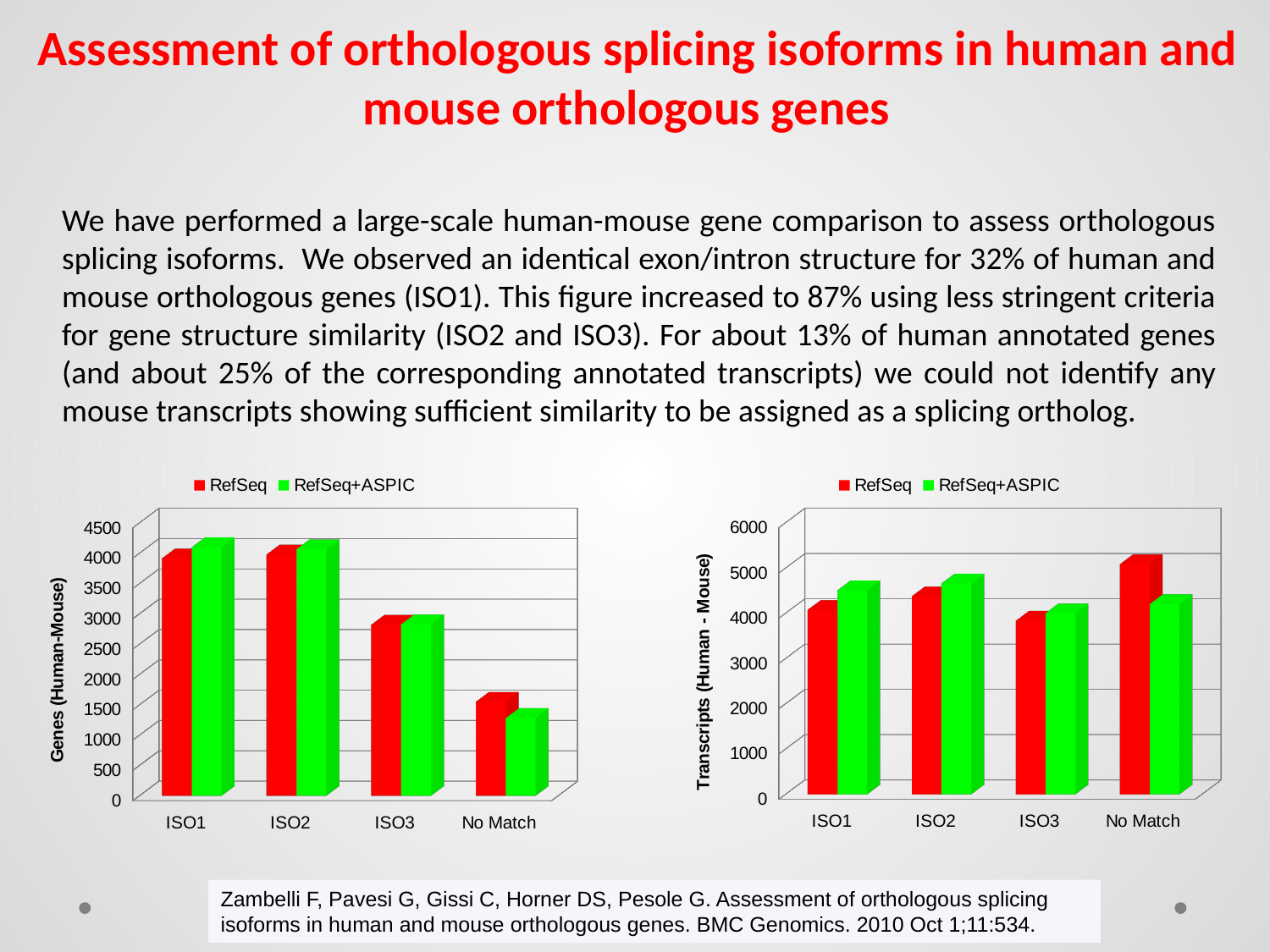
How many series does the legend of the left chart (Genes (Human-Mouse)) list? 2 How many categories are shown on the x axis of the right chart (Transcripts (Human - Mouse))? 4 In the right chart (Transcripts (Human - Mouse)), which category has the lowest RefSeq value? ISO3 In the right chart (Transcripts (Human - Mouse)), which category has the highest RefSeq value? No Match In the left chart (Genes (Human-Mouse)), is the RefSeq value for ISO3 greater or less than 2500? greater What kind of chart is the left chart (Genes (Human-Mouse))? bar chart In the left chart (Genes (Human-Mouse)), is the RefSeq+ASPIC value for No Match greater or less than 1500? less In the right chart (Transcripts (Human - Mouse)), for ISO1, which series has the larger value, RefSeq or RefSeq+ASPIC? RefSeq+ASPIC What is the y-axis label of the right chart? Transcripts (Human - Mouse) In the left chart (Genes (Human-Mouse)), which category has the lowest RefSeq value? No Match In the left chart (Genes (Human-Mouse)), for No Match, which series has the larger value, RefSeq or RefSeq+ASPIC? RefSeq